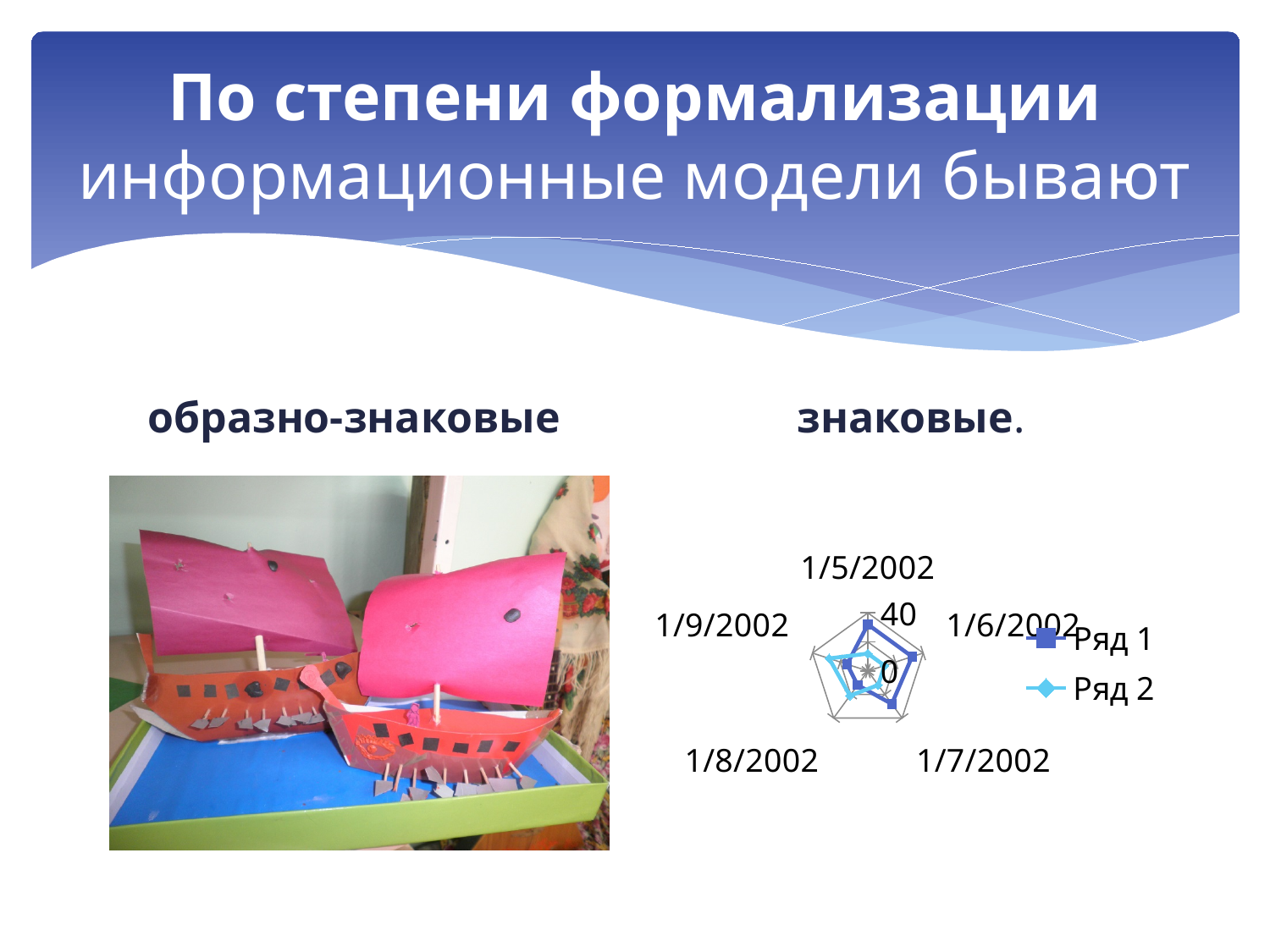
What kind of chart is shown on the right side of the slide? radar chart How many categories (dates) are plotted on the radar chart? 5 What is the highest axis tick value shown on the radar chart? 40 How many series does the legend of the radar chart list? 2 Which category label appears at the left of the radar chart? 1/9/2002 Which category label appears at the bottom right of the radar chart? 1/7/2002 Which category label appears at the top of the radar chart? 1/5/2002 What are the names of the series in the radar chart's legend? Ряд 1, Ряд 2